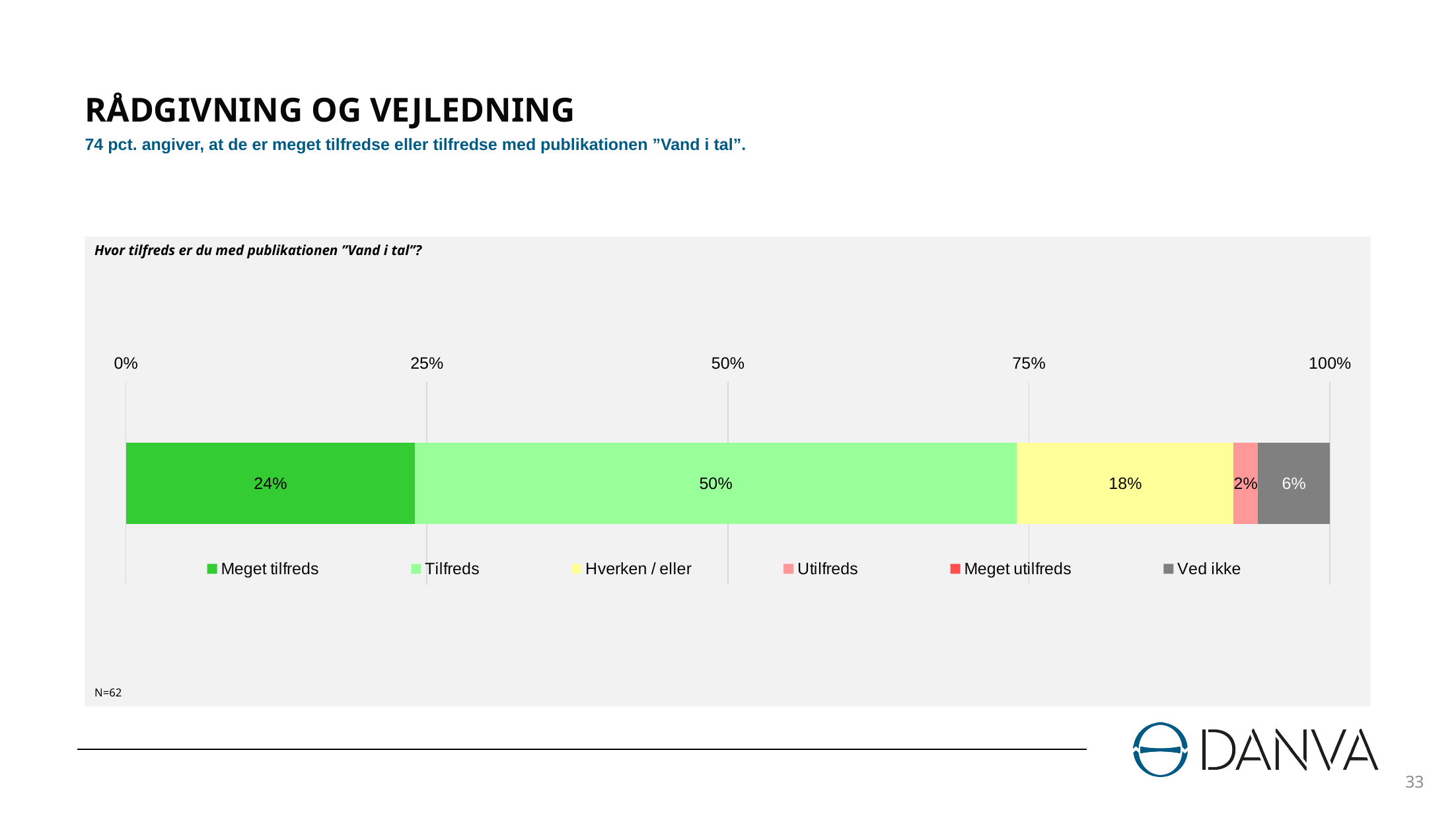
What percentage of respondents answered "Tilfreds"? 50% What is the difference between the share for "Tilfreds" and the share for "Meget tilfreds"? 26% What kind of chart is shown on the slide? Stacked bar chart Which response category has the largest share? Tilfreds What percentage of respondents answered "Hverken / eller"? 18% Which labelled segment in the bar has the smallest share? Utilfreds How many series does the legend list? 6 What percentage of respondents answered "Ved ikke"? 6% Which is larger, the share for "Hverken / eller" or the share for "Ved ikke"? Hverken / eller What percentage of respondents answered "Meget tilfreds"? 24% What is the combined share of "Meget tilfreds" and "Tilfreds"? 74% What is the question shown as the chart's title? Hvor tilfreds er du med publikationen "Vand i tal"?